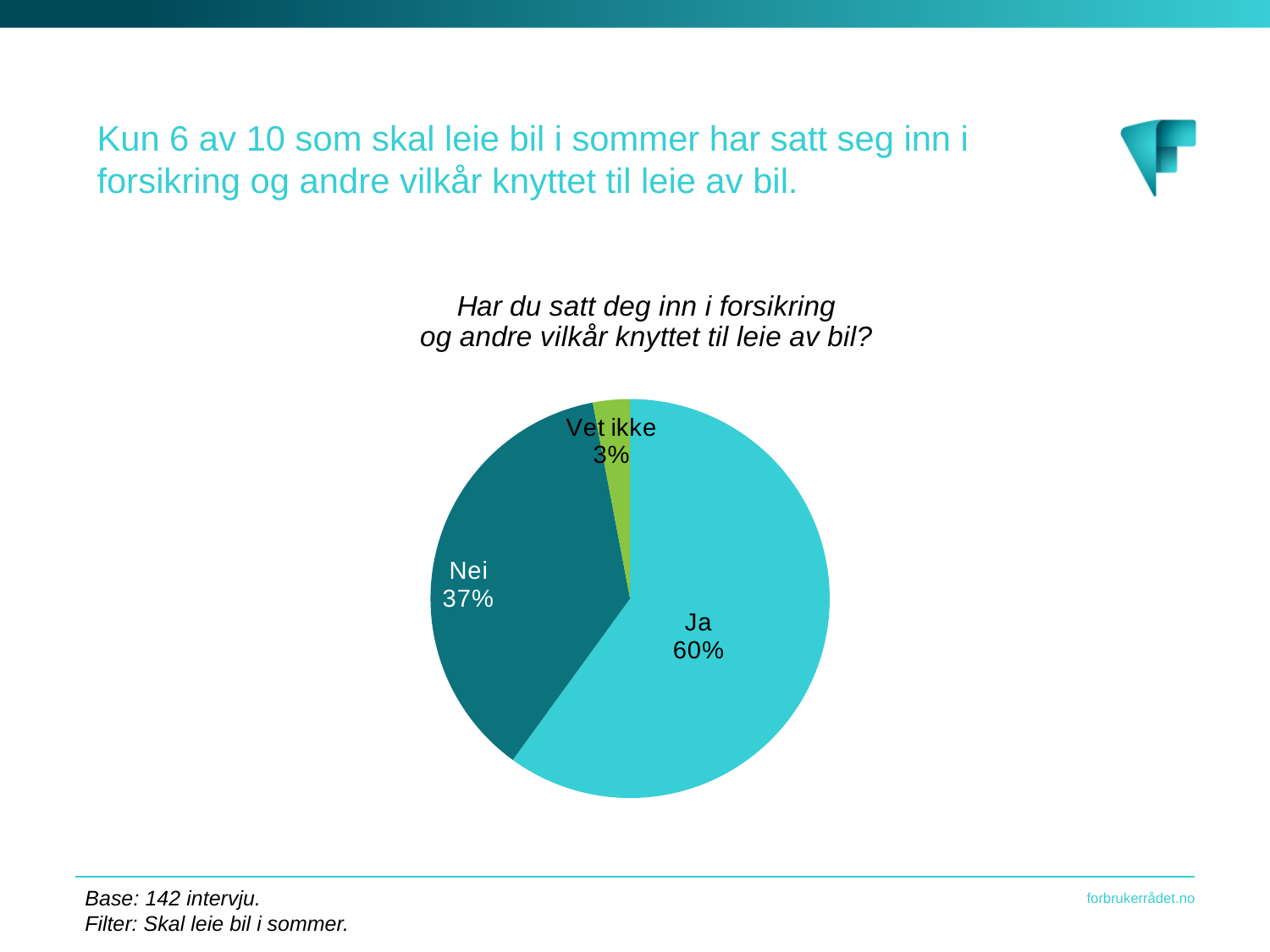
What is the difference in percentage points between "Ja" and "Nei"? 23 Which answer has the largest share of the pie? Ja How many slices does the pie chart have? 3 What colour is the "Vet ikke" slice? green What percentage of respondents answered "Nei"? 37% Which is larger, the share for "Nei" or the share for "Vet ikke"? Nei What percentage of respondents answered "Ja"? 60% What type of chart is shown on the slide? pie chart What question is the pie chart titled with? Har du satt deg inn i forsikring og andre vilkår knyttet til leie av bil? Which answer has the smallest share of the pie? Vet ikke What percentage of respondents answered "Vet ikke"? 3% What is the combined share of "Nei" and "Vet ikke"? 40%